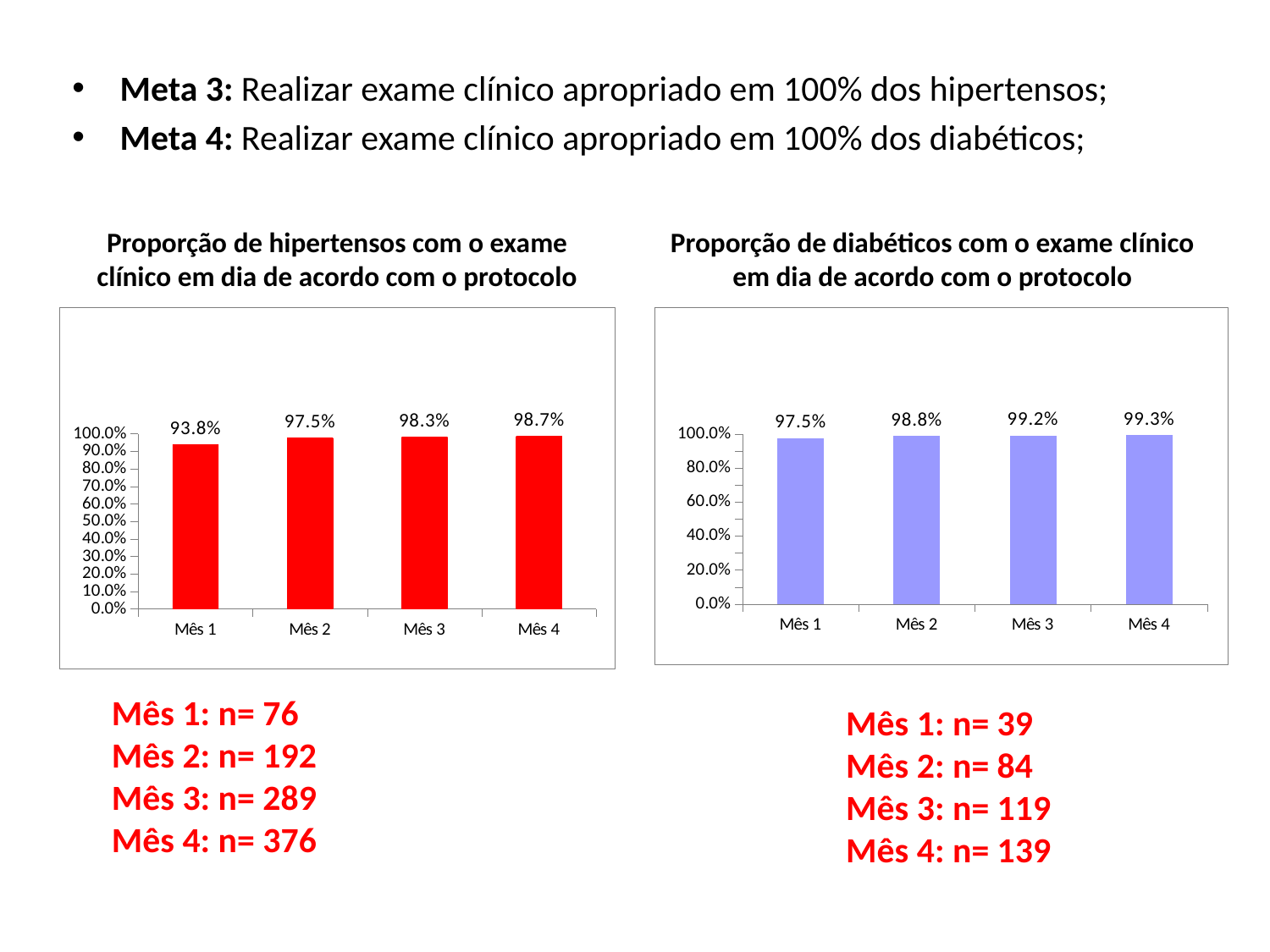
Which is larger: the Mês 2 value in the hipertensos chart (left) or the Mês 2 value in the diabéticos chart (right)? The diabéticos chart (98.8%) In the chart 'Proporção de hipertensos com o exame clínico em dia de acordo com o protocolo', which month has the lowest value? Mês 1 In the chart 'Proporção de diabéticos com o exame clínico em dia de acordo com o protocolo', do the values rise or fall from Mês 1 to Mês 4? Rise In the chart 'Proporção de hipertensos com o exame clínico em dia de acordo com o protocolo', what is the value for Mês 1? 93.8% What colour are the bars in the chart 'Proporção de hipertensos com o exame clínico em dia de acordo com o protocolo'? Red In the chart 'Proporção de hipertensos com o exame clínico em dia de acordo com o protocolo', what is the difference between the values for Mês 4 and Mês 1? 4.9% In the chart 'Proporção de diabéticos com o exame clínico em dia de acordo com o protocolo', what is the difference between the values for Mês 2 and Mês 1? 1.3% What kind of chart is 'Proporção de hipertensos com o exame clínico em dia de acordo com o protocolo'? Bar chart In the chart 'Proporção de diabéticos com o exame clínico em dia de acordo com o protocolo', which month has the highest value? Mês 4 In the chart 'Proporção de hipertensos com o exame clínico em dia de acordo com o protocolo', is the value for Mês 1 greater or less than 90.0%? greater In the chart 'Proporção de diabéticos com o exame clínico em dia de acordo com o protocolo', what is the value for Mês 4? 99.3% How many months (categories) are shown in the chart 'Proporção de diabéticos com o exame clínico em dia de acordo com o protocolo'? 4